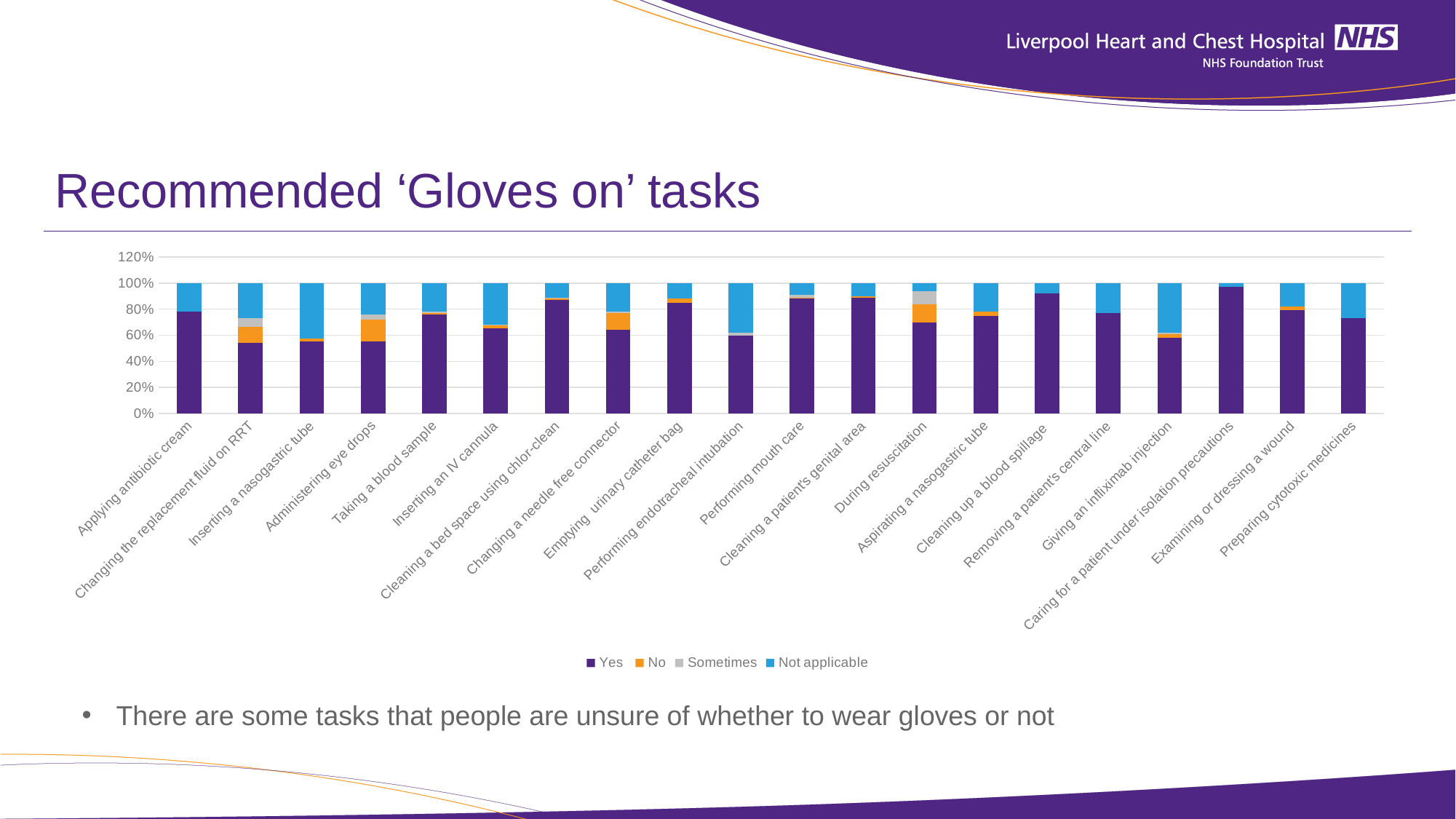
Is the 'Yes' value for 'Cleaning up a blood spillage' greater or less than 80%? greater What are the four series named in the chart legend? Yes, No, Sometimes, Not applicable Which has the larger 'Yes' share: 'Cleaning up a blood spillage' or 'Performing endotracheal intubation'? Cleaning up a blood spillage Which task has the highest 'Yes' share in the chart? Caring for a patient under isolation precautions How many tasks (categories) are plotted along the x axis of the chart? 20 Is the 'Yes' value for 'Applying antibiotic cream' greater or less than 60%? greater What kind of chart is shown on the slide? Stacked bar chart Is the 'Yes' value for 'Performing endotracheal intubation' greater or less than 80%? less What is the title of the slide containing the chart? Recommended 'Gloves on' tasks What total does each stacked bar in the chart reach on the y axis? 100% How many series does the chart legend list? 4